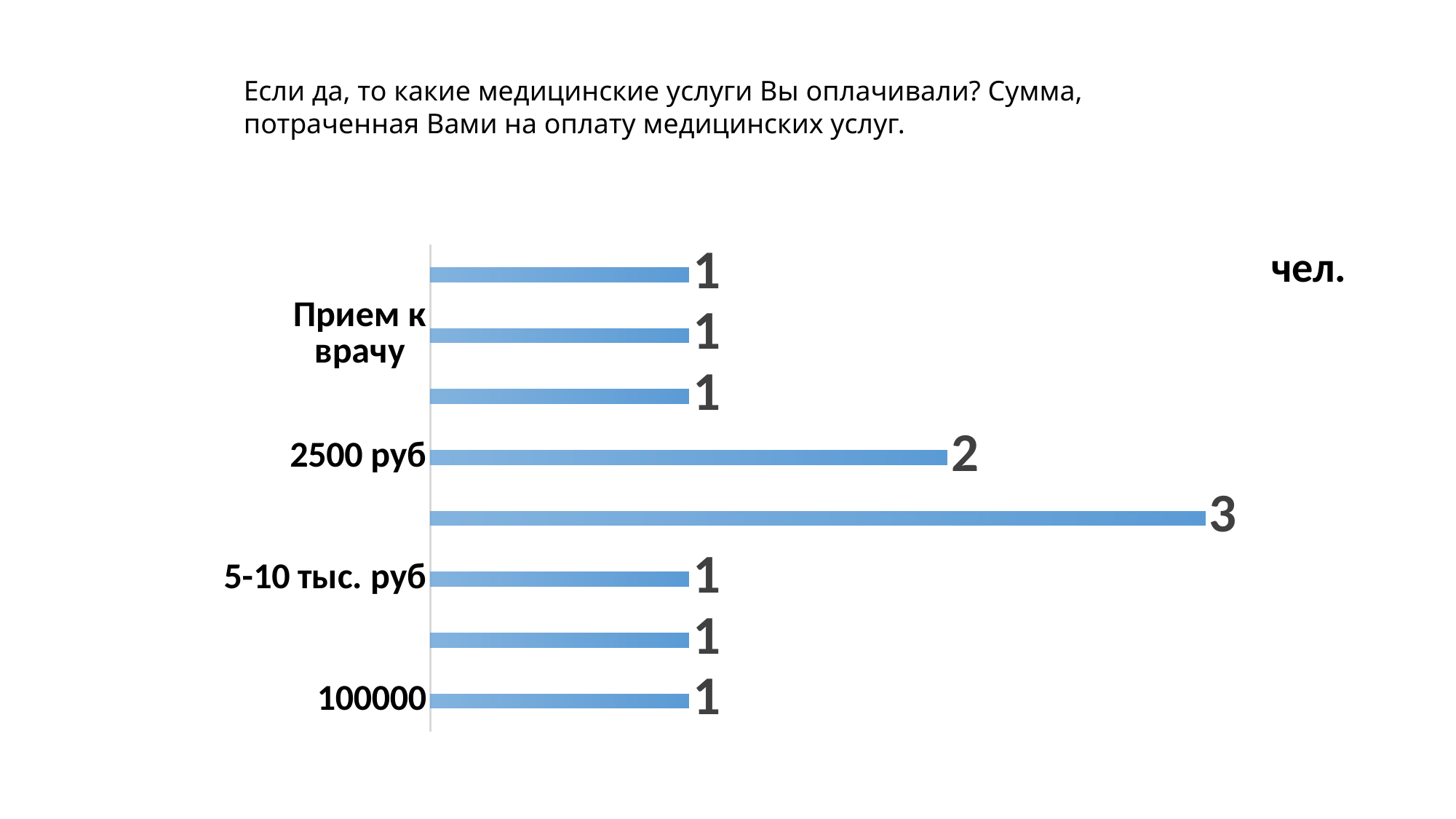
What is the largest value shown on any bar in the chart? 3 Which is larger, the value for "2500 руб" or the value for "5-10 тыс. руб"? 2500 руб How many bars in the chart have a value of 1? 6 What is the difference between the value for "2500 руб" and the value for "100000"? 1 What kind of chart is shown on the slide? bar chart What is the value for "5-10 тыс. руб"? 1 What is the value for "Прием к врачу"? 1 What unit label is shown at the top right of the chart? чел. What is the value for "100000"? 1 What is the value for "2500 руб"? 2 How many bars are plotted in the chart? 8